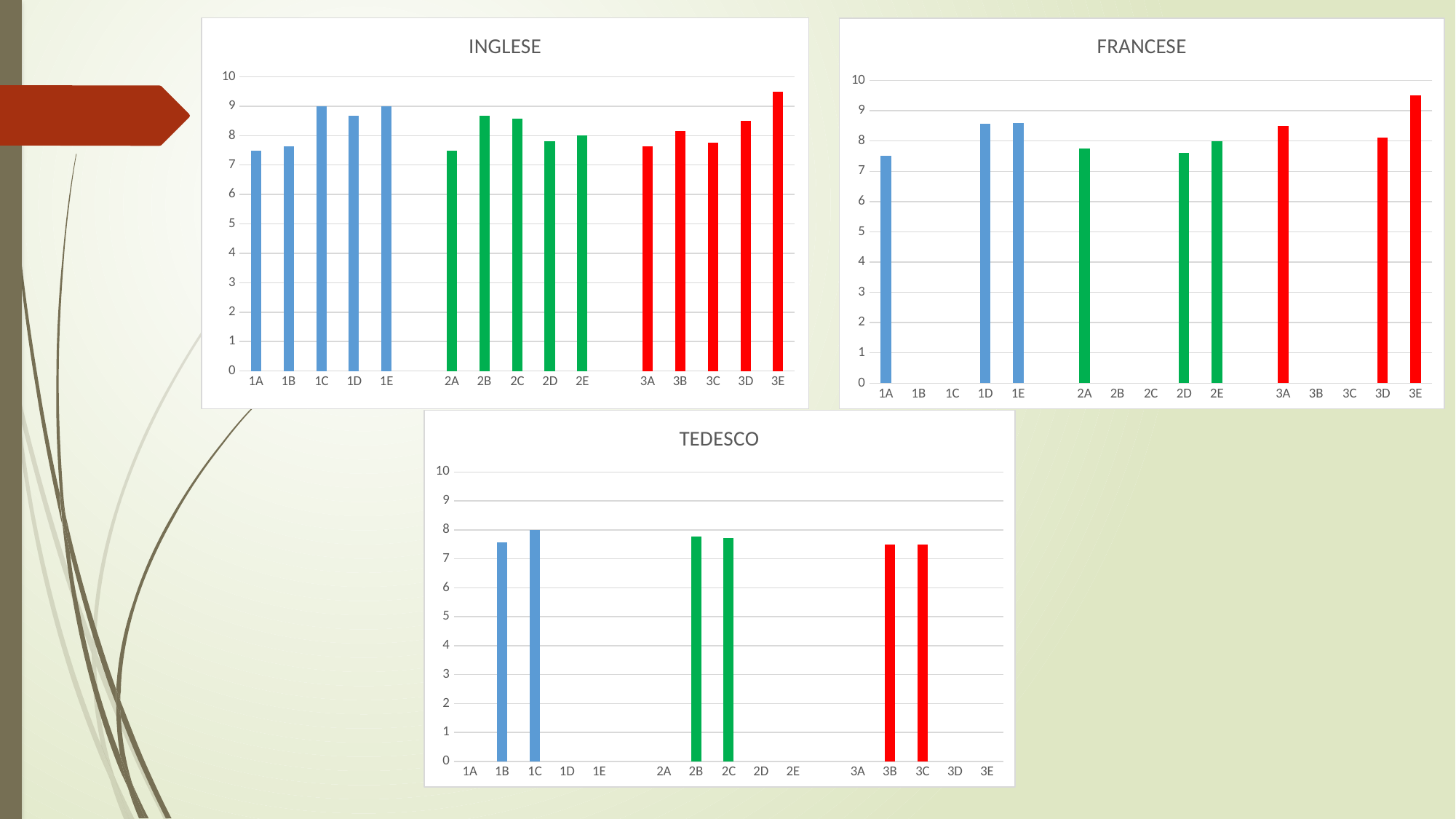
In the INGLESE chart, which is larger, the value for 1C or the value for 1A? 1C In the TEDESCO chart, what is the value for 1C? 8 In the INGLESE chart, is the value for 1A greater or less than 8? less What type of chart is the INGLESE chart? bar chart In the TEDESCO chart, is the value for 3B greater or less than 8? less How many categories are listed on the x axis of the FRANCESE chart? 15 In the FRANCESE chart, which category has the highest value? 3E In the INGLESE chart, what is the value for 1C? 9 In the INGLESE chart, which category has the highest value? 3E What are the titles of the three charts on the slide? INGLESE, FRANCESE, TEDESCO How many bars are plotted in the TEDESCO chart? 6 In the INGLESE chart, is the value for 3E greater or less than 9? greater